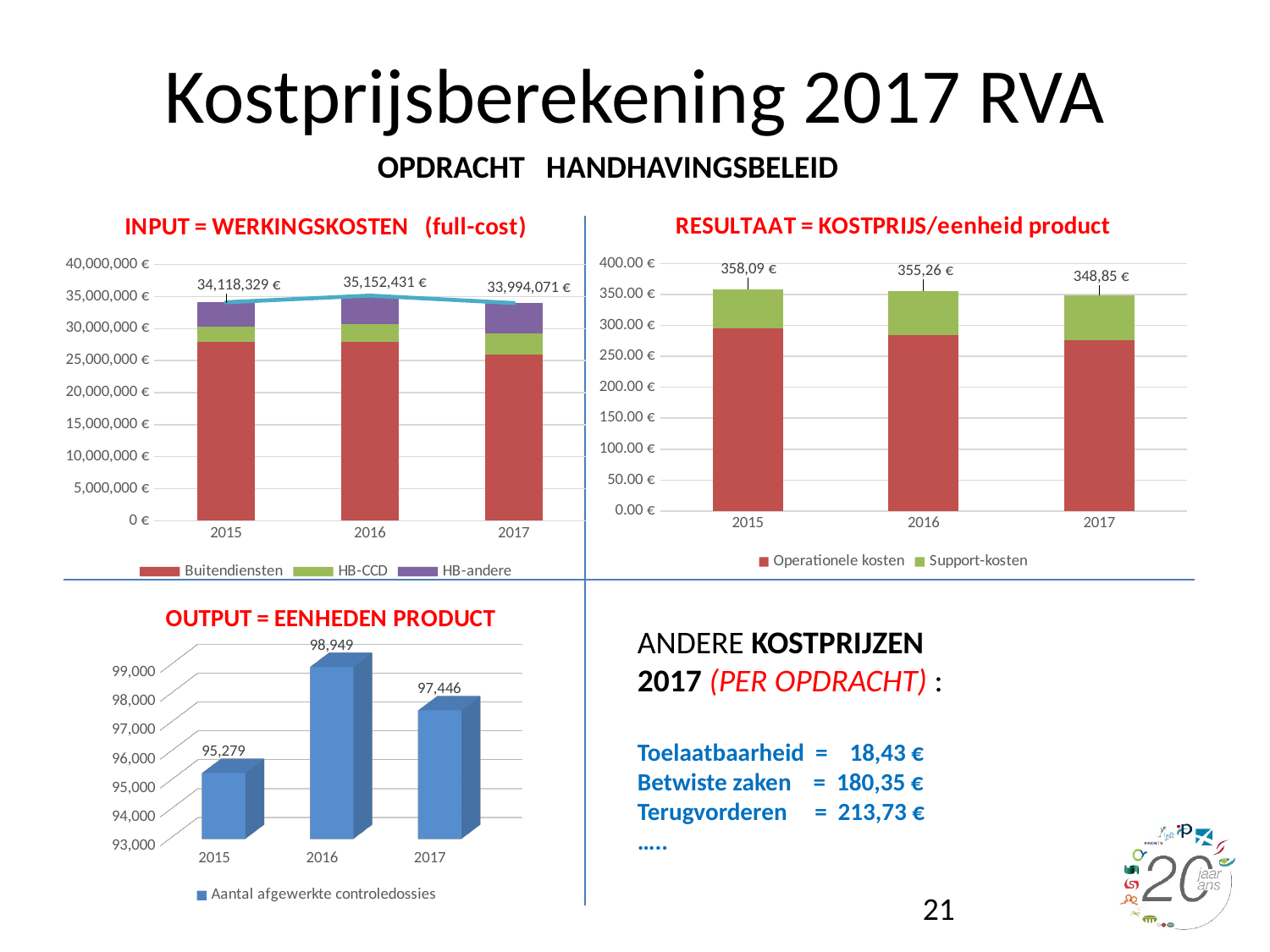
What kind of chart is the 'OUTPUT = EENHEDEN PRODUCT' chart? bar chart In the 'OUTPUT = EENHEDEN PRODUCT' chart, which is larger, the value for 2017 or the value for 2015? 2017 How many series does the legend of the 'INPUT = WERKINGSKOSTEN (full-cost)' chart list? 3 In the 'OUTPUT = EENHEDEN PRODUCT' chart, what is the value for 2016? 98,949 In the 'INPUT = WERKINGSKOSTEN (full-cost)' chart, which year has the lowest total? 2017 In the 'RESULTAAT = KOSTPRIJS/eenheid product' chart, which year has the highest value? 2015 In the 'RESULTAAT = KOSTPRIJS/eenheid product' chart, is the Operationele kosten portion for 2015 greater or less than 250.00 €? greater In the 'INPUT = WERKINGSKOSTEN (full-cost)' chart, what is the total value shown for 2016? 35,152,431 € In the 'INPUT = WERKINGSKOSTEN (full-cost)' chart, what is the difference between the 2016 total and the 2015 total? 1,034,102 € In the 'RESULTAAT = KOSTPRIJS/eenheid product' chart, what is the value shown for 2017? 348,85 € In the 'RESULTAAT = KOSTPRIJS/eenheid product' chart, do the values rise or fall from 2015 to 2017? fall In the 'OUTPUT = EENHEDEN PRODUCT' chart, what is the difference between the 2016 value and the 2015 value? 3,670